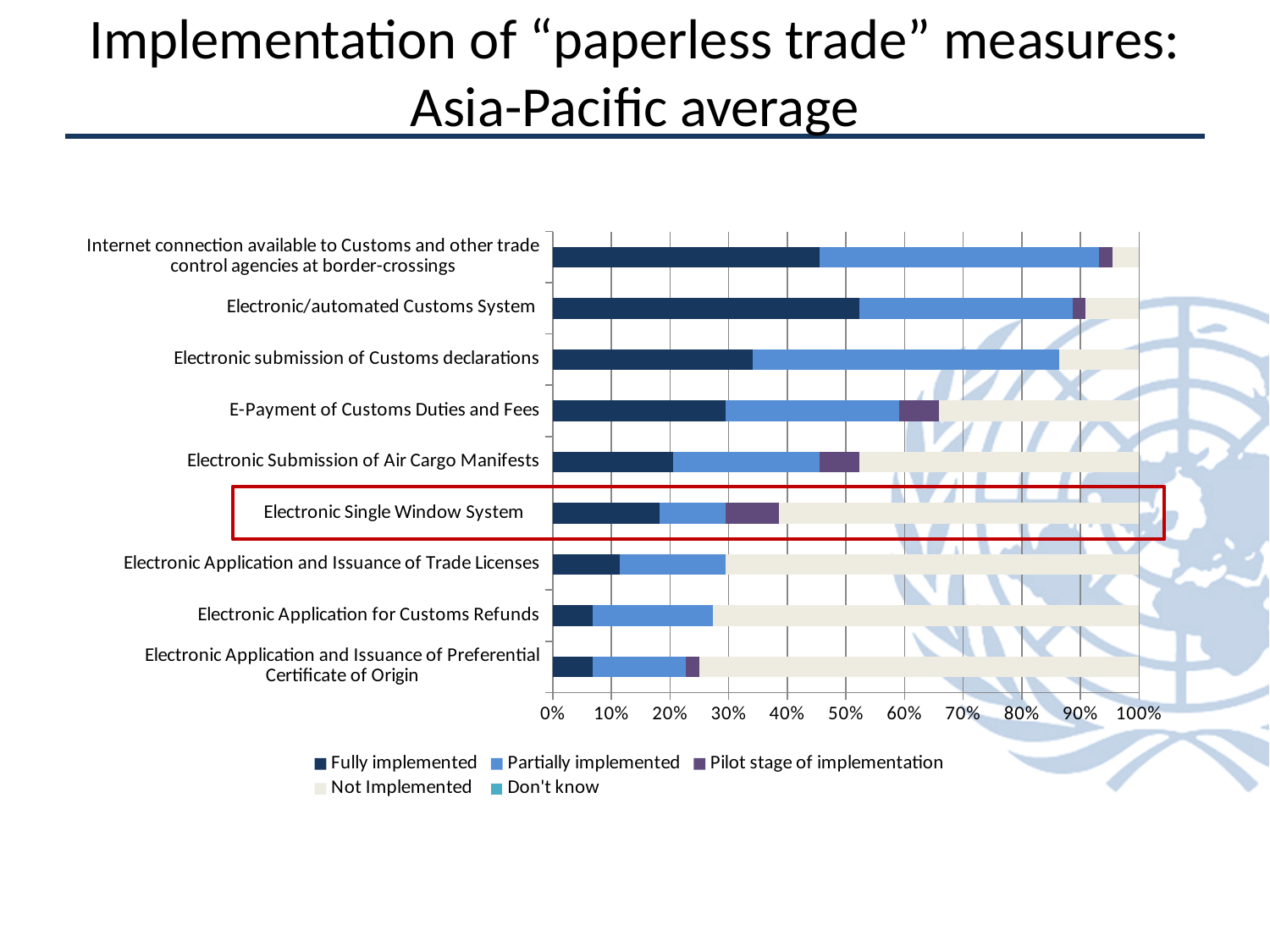
Which has a larger 'Fully implemented' share: 'Electronic submission of Customs declarations' or 'Electronic Submission of Air Cargo Manifests'? Electronic submission of Customs declarations Is the 'Fully implemented' value for 'Electronic Single Window System' greater or less than 20%? less Is the 'Fully implemented' value for 'Electronic Application and Issuance of Trade Licenses' greater or less than 20%? less Which category on the chart is highlighted with a red box? Electronic Single Window System How many paperless trade measures (categories) are plotted on the chart? 9 Is the 'Fully implemented' value for 'E-Payment of Customs Duties and Fees' greater or less than 20%? greater What kind of chart is shown on the slide? Stacked bar chart Which measure has the largest 'Fully implemented' share? Electronic/automated Customs System What is the title of the slide containing the chart? Implementation of "paperless trade" measures: Asia-Pacific average How many series does the chart legend list? 5 Which has a larger 'Fully implemented' share: 'Internet connection available to Customs and other trade control agencies at border-crossings' or 'Electronic submission of Customs declarations'? Internet connection available to Customs and other trade control agencies at border-crossings